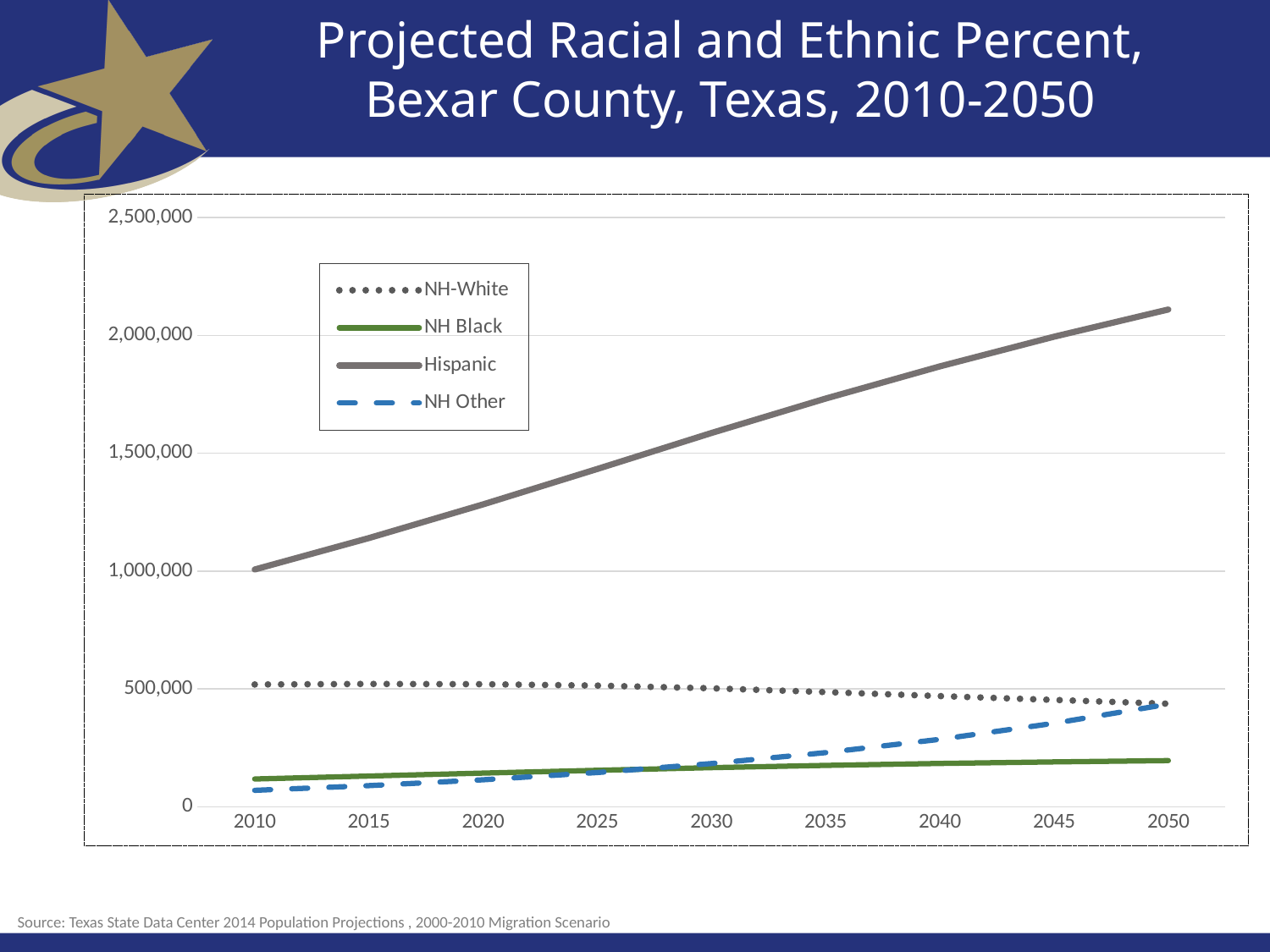
In 2050, which is larger: NH Other or NH Black? NH Other Which series has the highest value in 2050? Hispanic Is the value for Hispanic in 2050 greater or less than 2,000,000? greater How many year labels are shown along the x axis? 9 How many series does the legend list? 4 Is the value for NH Black in 2050 greater or less than 500,000? less What kind of chart is shown on the slide? Line chart Which series is drawn with a dotted line in the legend? NH-White Which series has the lowest value in 2010? NH Other Does the NH-White series rise or fall from 2010 to 2050? Fall Is the value for Hispanic in 2020 greater or less than 1,500,000? less Does the Hispanic series rise or fall from 2010 to 2050? Rise